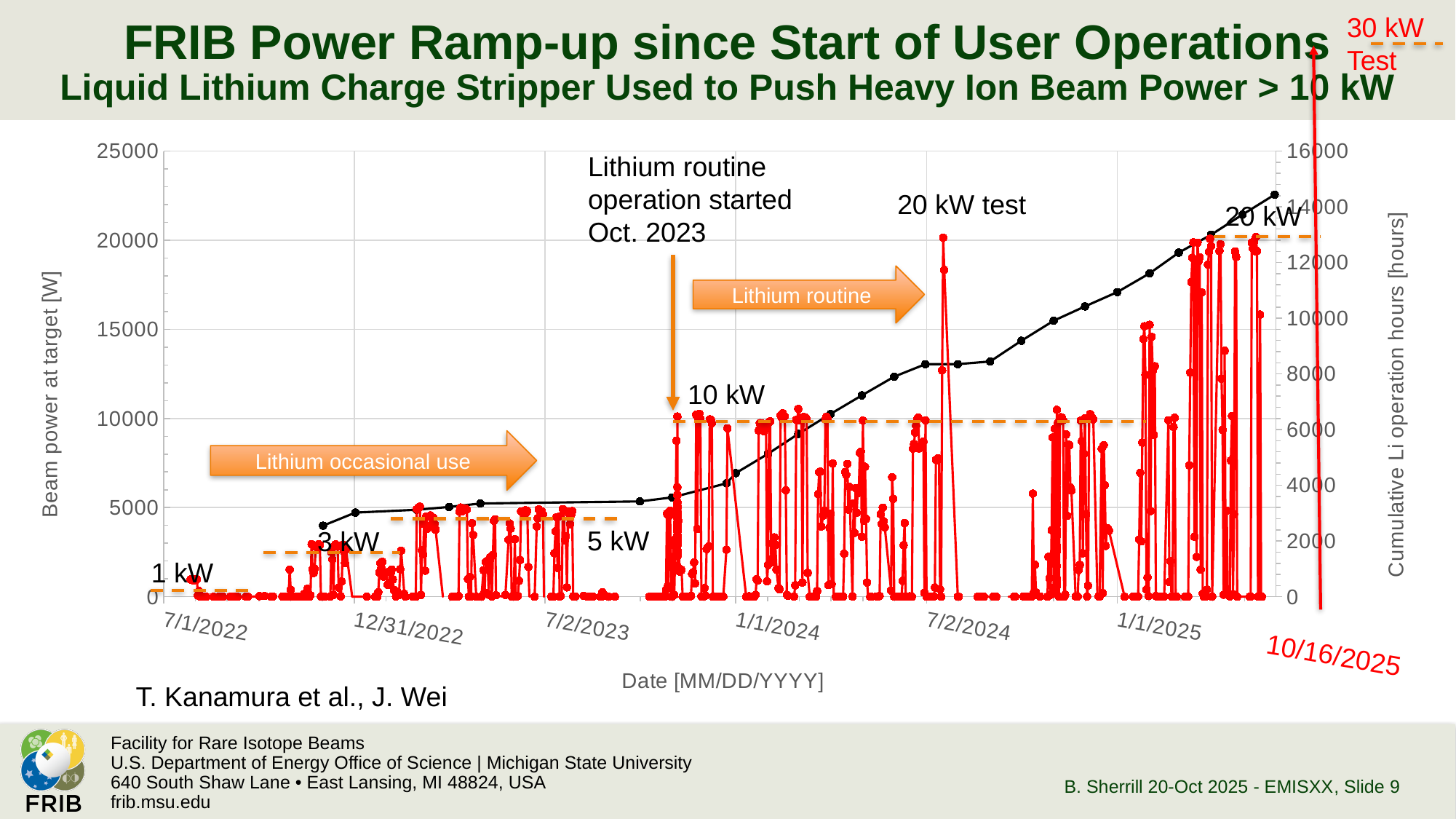
Is the final value of the cumulative Li operation hours line greater or less than 12000 hours? greater Is the beam power at the 20 kW test peak greater or less than 15000 W? greater What kind of chart is shown on the slide? line chart What is the highest tick value on the left vertical axis? 25000 According to the annotation, when did lithium routine operation start? Oct. 2023 What is the highest tick value on the right vertical axis? 16000 What is the title of the left vertical axis? Beam power at target [W] Is the beam power at target before 12/31/2022 greater or less than 5000 W? less What is the title of the right vertical axis? Cumulative Li operation hours [hours] Does the cumulative Li operation hours line rise or fall along the x axis? rise What power level is labeled for the test peak near 7/2/2024? 20 kW test How many date labels are shown on the x axis? 6